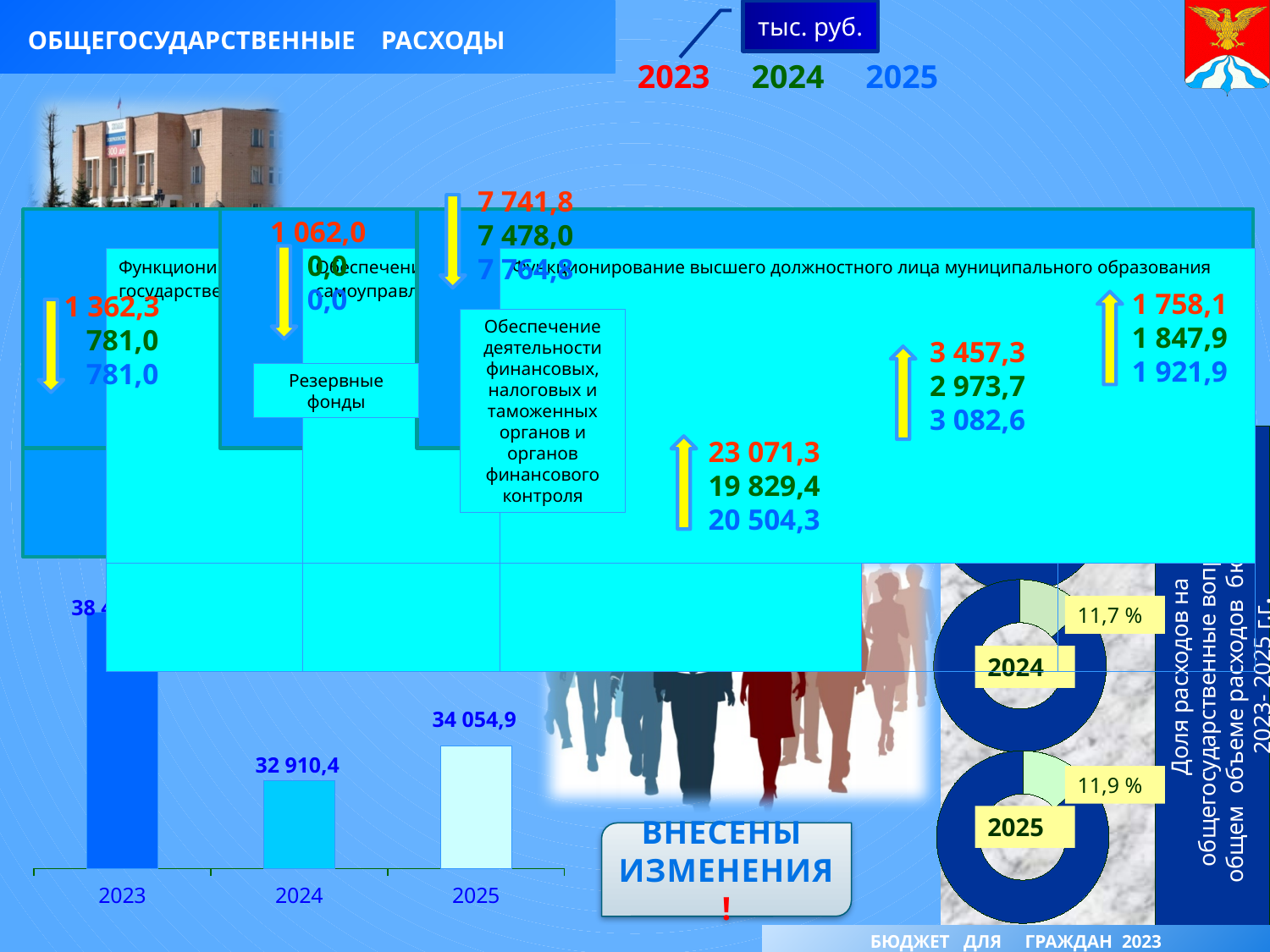
What type of chart is shown at the bottom left of the slide? bar chart In the bar chart at the bottom left of the slide, what is the value for 2024? 32 910,4 In the bar chart at the bottom left of the slide, what is the value for 2025? 34 054,9 In the bar chart at the bottom left of the slide, which year has the highest bar? 2023 In the bar chart at the bottom left of the slide, which year has the lowest bar? 2024 In the donut chart labelled 2025 on the right of the slide, what share is shown by the data label? 11,9 % How many bars are shown in the bar chart at the bottom left of the slide? 3 In the donut chart labelled 2024 on the right of the slide, what share is shown by the data label? 11,7 % What years are labelled on the x axis of the bar chart at the bottom left of the slide? 2023, 2024, 2025 Comparing the donut charts on the right of the slide, which year shows the larger share: 2024 or 2025? 2025 In the bar chart at the bottom left of the slide, what is the difference between the values for 2025 and 2024? 1 144,5 In the bar chart at the bottom left of the slide, which is larger: the value for 2024 or the value for 2025? 2025